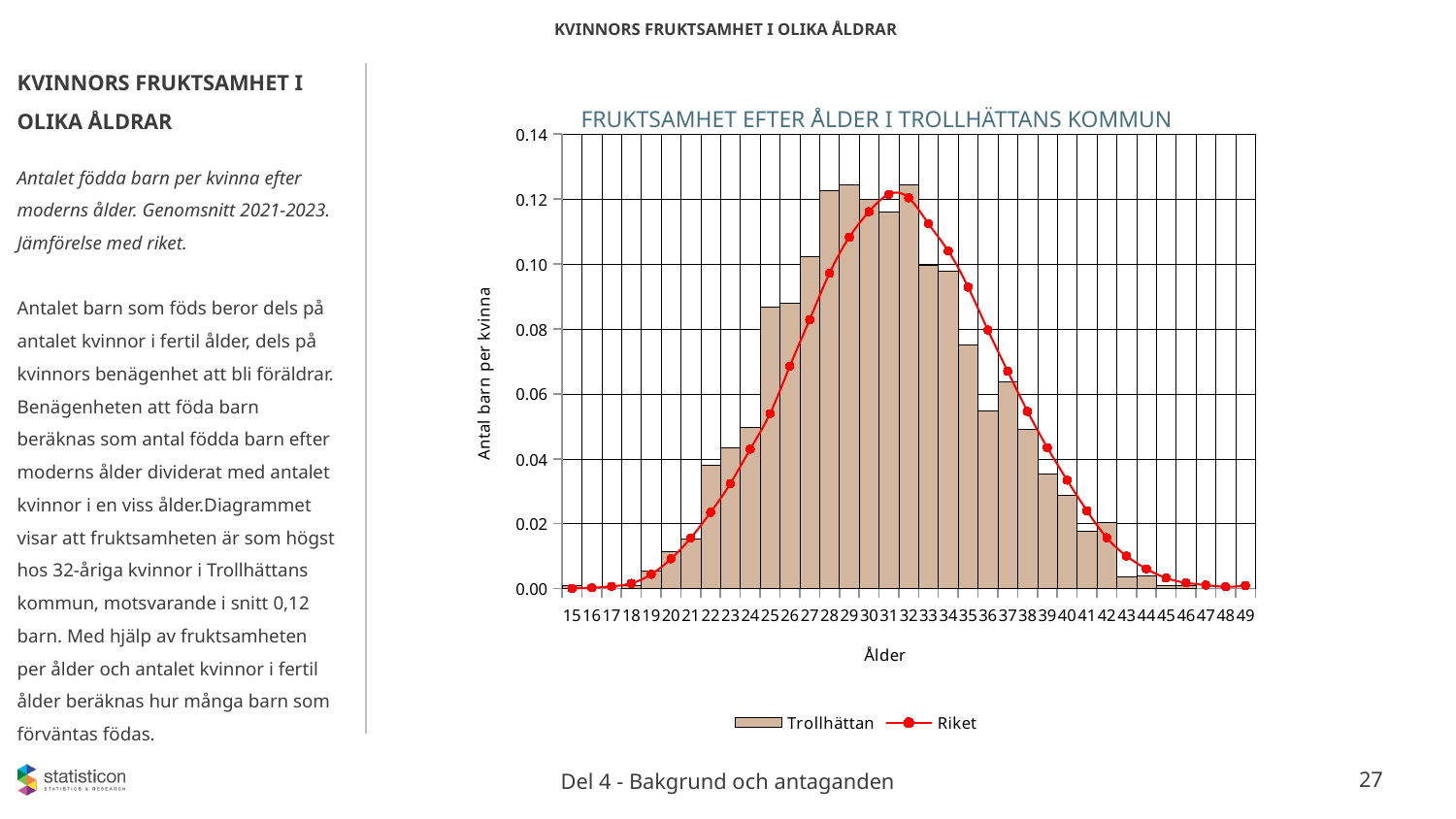
Which series is shown as a red line with markers? Riket What kind of chart is this? Combined bar and line chart How many age categories are shown on the x axis? 35 Is the Riket value for age 38 greater or less than 0.06? less Is the Riket value for age 26 greater or less than 0.06? greater Is the Trollhättan value for age 35 greater or less than 0.08? less How many series does the chart legend list? 2 What is the title of the chart? FRUKTSAMHET EFTER ÅLDER I TROLLHÄTTANS KOMMUN Do the Riket values rise or fall from age 33 to age 49? fall At age 35, which is larger, the Trollhättan value or the Riket value? Riket